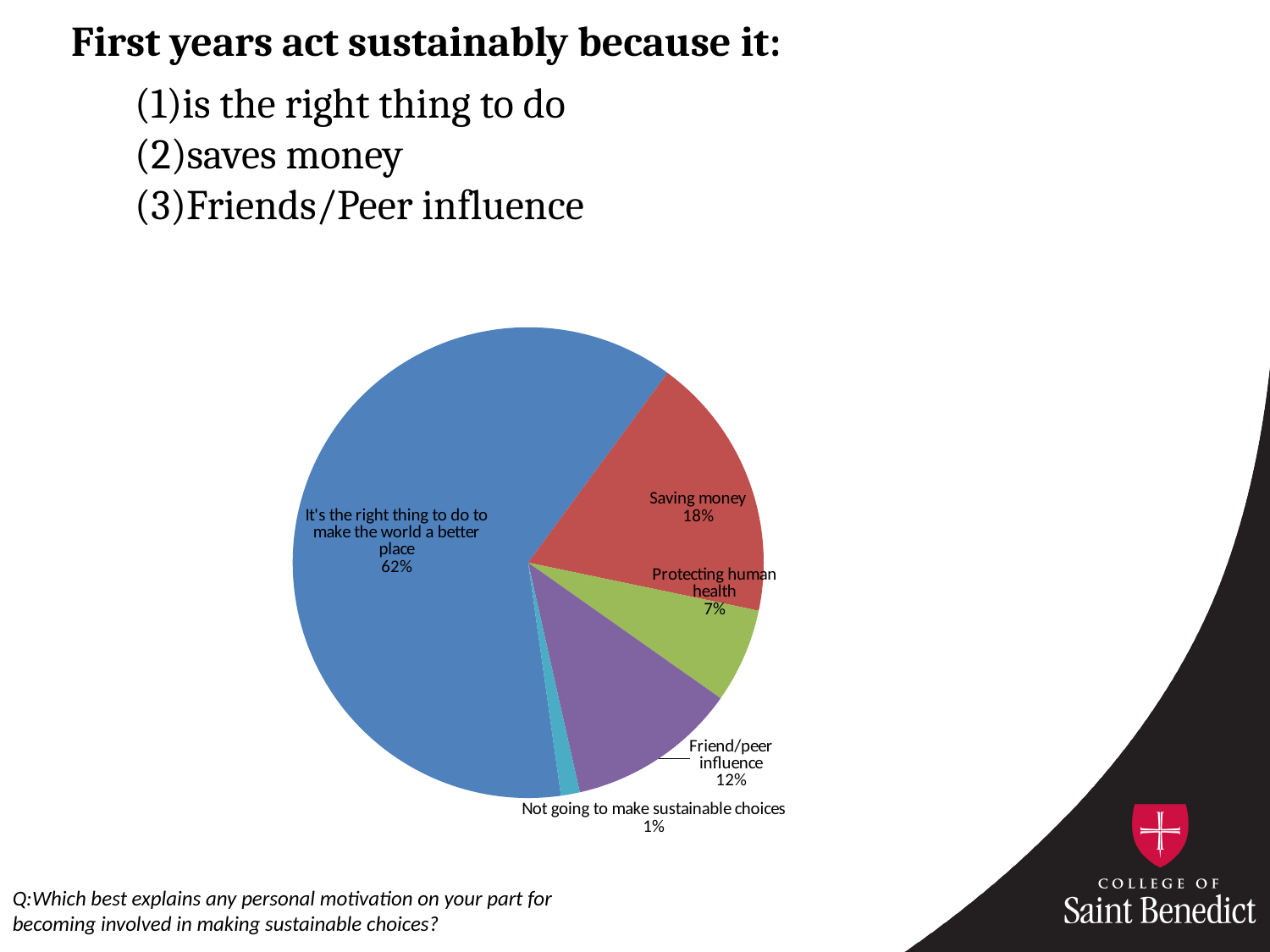
What kind of chart is shown on the slide? pie chart Which is larger, the slice for "Protecting human health" or the slice for "Friend/peer influence"? Friend/peer influence What share of the pie is labelled "Saving money"? 18% What is the difference in percentage points between "Saving money" and "Friend/peer influence"? 6 How many slices does the pie chart have? 5 Which slice of the pie is the largest? It's the right thing to do to make the world a better place What percentage is shown for "Protecting human health"? 7% What is the difference in percentage points between the largest slice and "Saving money"? 44 What percentage is shown for "Not going to make sustainable choices"? 1% What percentage is shown for "Friend/peer influence"? 12% What colour is the "Saving money" slice? red Which slice of the pie is the smallest? Not going to make sustainable choices